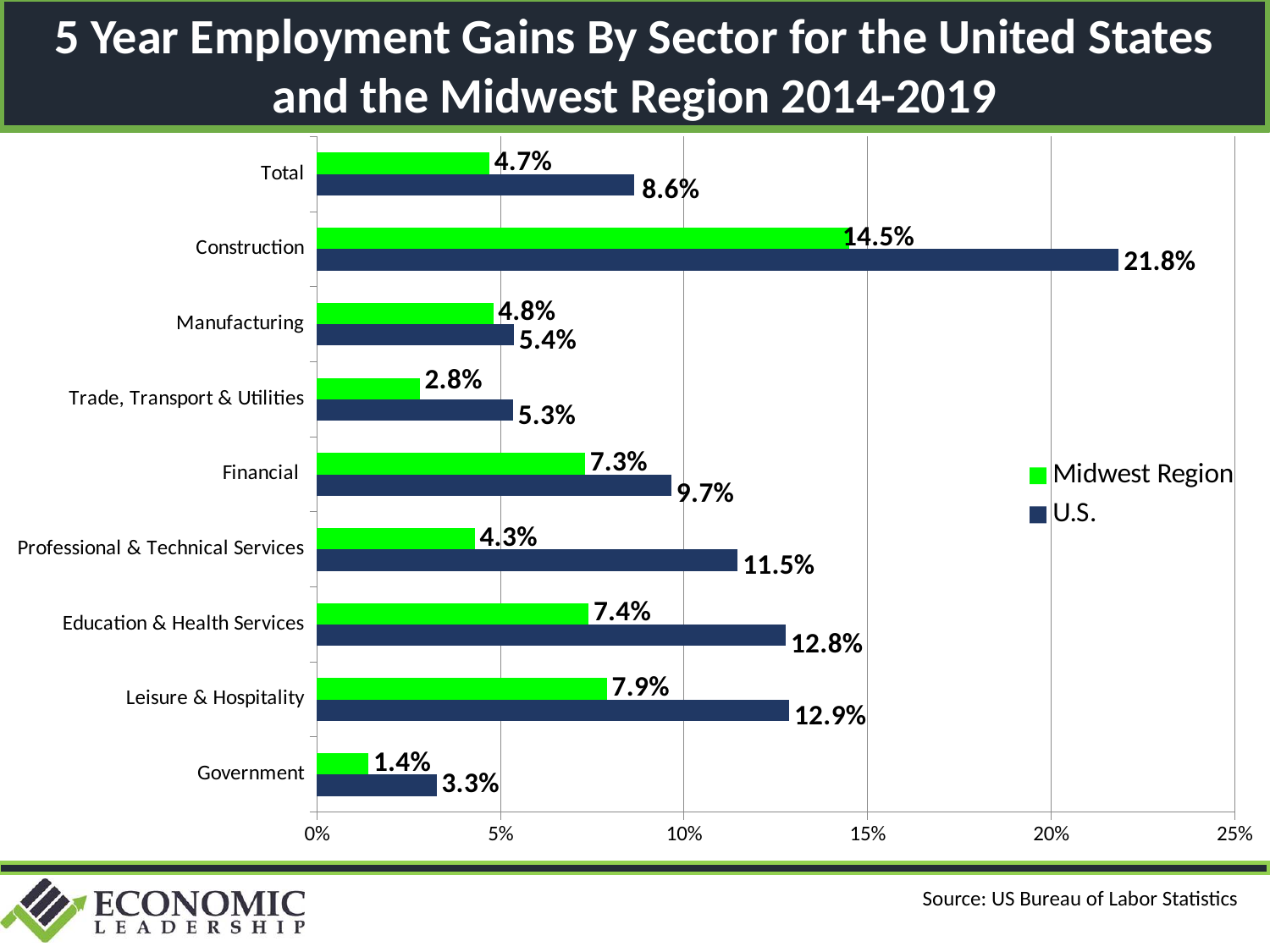
What is the Midwest Region value for Leisure & Hospitality? 7.9% What kind of chart is shown on the slide? Bar chart Which sector has the highest U.S. employment gain? Construction Which sector has the lowest Midwest Region employment gain? Government Which is larger for Financial: the U.S. value or the Midwest Region value? U.S. What is the U.S. employment gain for Construction? 21.8% What is the Midwest Region employment gain for Trade, Transport & Utilities? 2.8% What is the difference between the U.S. and Midwest Region values for Professional & Technical Services? 7.2% How many series does the legend list? 2 What colour represents the Midwest Region series? Green Is the U.S. value for Education & Health Services greater or less than 10%? greater How many sector categories are shown on the chart? 9